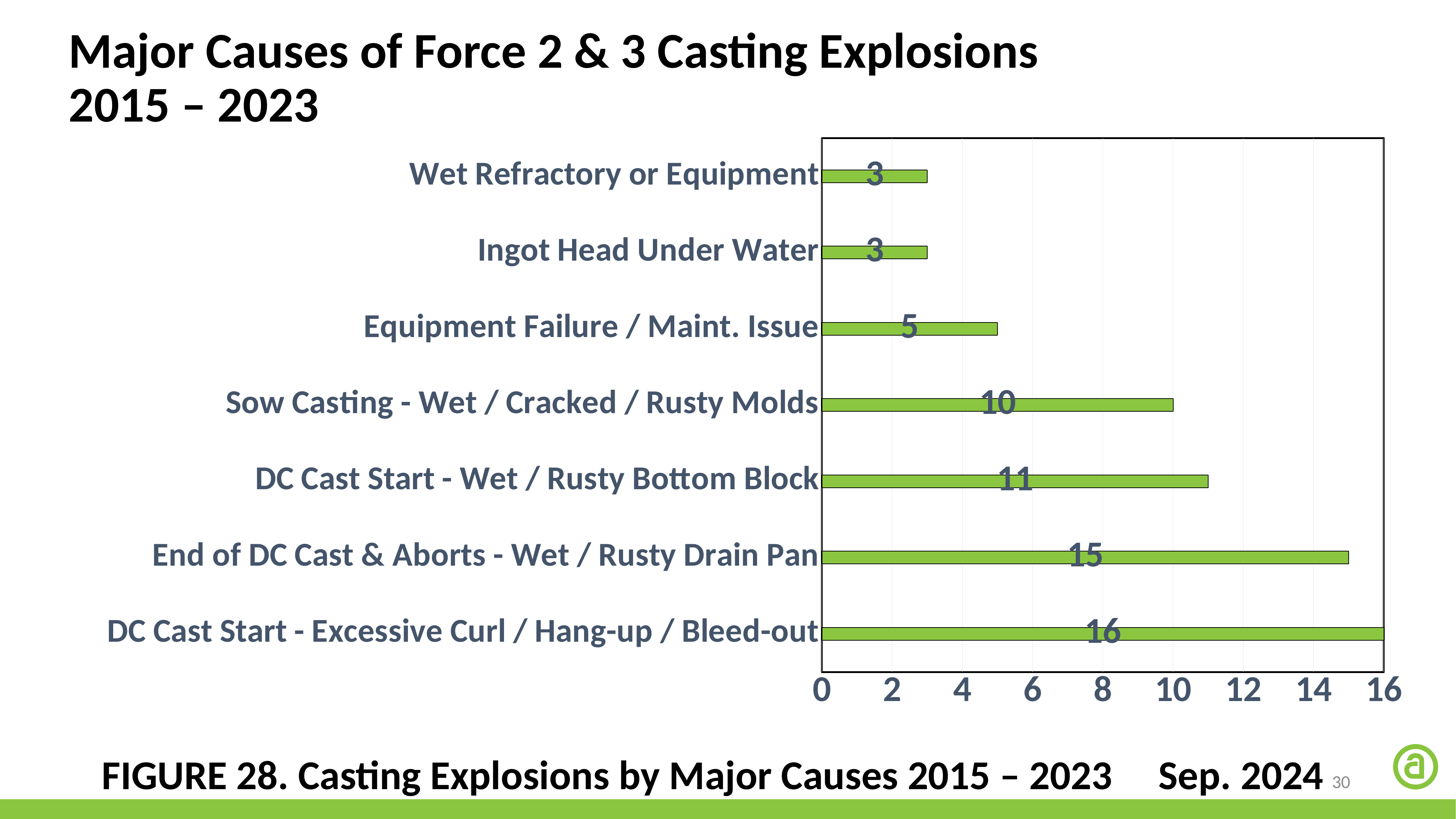
How many causes are shown in the chart? 7 What is the value for DC Cast Start - Excessive Curl / Hang-up / Bleed-out? 16 What is the figure caption below the chart? FIGURE 28. Casting Explosions by Major Causes 2015 – 2023 Which is larger, Sow Casting - Wet / Cracked / Rusty Molds or Equipment Failure / Maint. Issue? Sow Casting - Wet / Cracked / Rusty Molds What is the difference between End of DC Cast & Aborts - Wet / Rusty Drain Pan and DC Cast Start - Wet / Rusty Bottom Block? 4 What is the value for Equipment Failure / Maint. Issue? 5 Is the value for End of DC Cast & Aborts - Wet / Rusty Drain Pan greater or less than 12? greater Which cause has the highest value? DC Cast Start - Excessive Curl / Hang-up / Bleed-out What is the value for Ingot Head Under Water? 3 What is the difference between DC Cast Start - Excessive Curl / Hang-up / Bleed-out and Wet Refractory or Equipment? 13 What kind of chart is shown on the slide? bar chart What is the value for Sow Casting - Wet / Cracked / Rusty Molds? 10